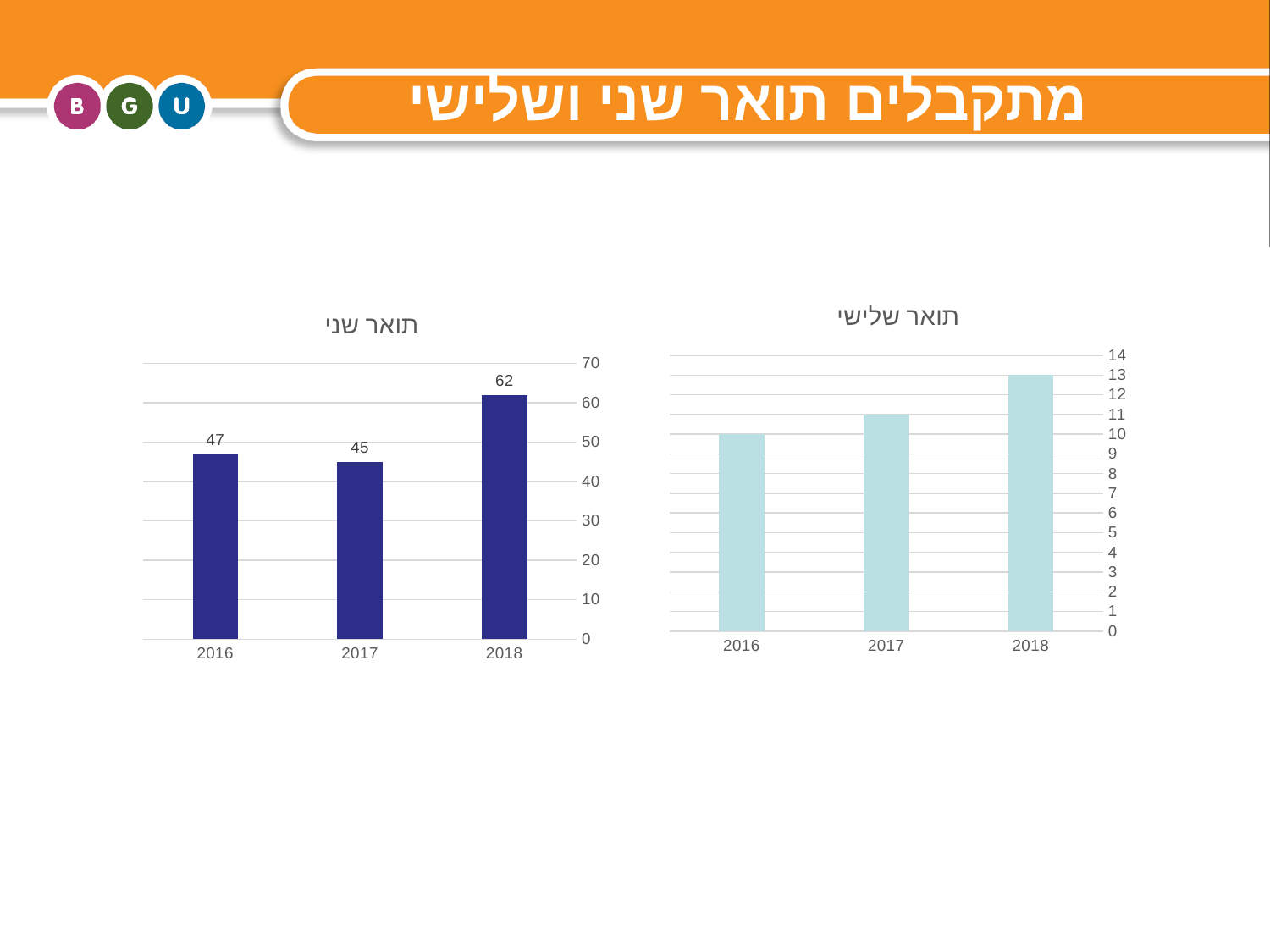
What kind of chart is the chart titled תואר שלישי (right)? bar chart In the chart titled תואר שלישי (right), is the value for 2018 greater or less than 12? greater In the chart titled תואר שני (left), what is the difference between the values for 2018 and 2017? 17 In the chart titled תואר שלישי (right), which year has the highest value? 2018 In the chart titled תואר שני (left), which year has the lowest value? 2017 In the chart titled תואר שלישי (right), do the values rise or fall from 2016 to 2018? rise In the chart titled תואר שני (left), which year has the highest value? 2018 How many years are shown on the x axis of the chart titled תואר שני (left)? 3 In the chart titled תואר שני (left), what is the value for 2018? 62 In the chart titled תואר שני (left), which is larger, the value for 2016 or the value for 2017? 2016 In the chart titled תואר שני (left), what is the value for 2016? 47 In the chart titled תואר שלישי (right), is the value for 2016 greater or less than 12? less